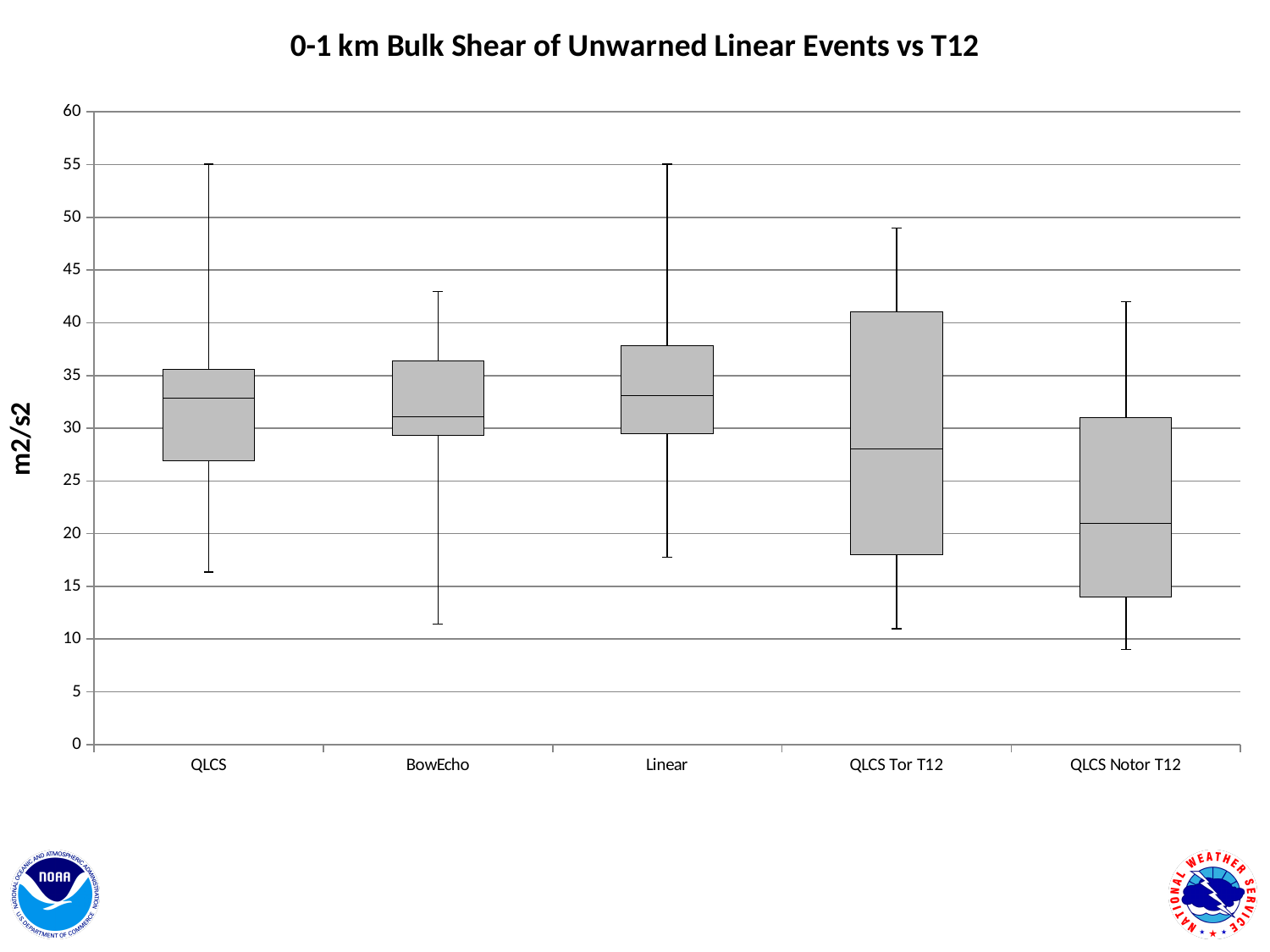
Which has the higher median, QLCS or QLCS Notor T12? QLCS Which category has the lowest bottom whisker? QLCS Notor T12 What is the title of the chart? 0-1 km Bulk Shear of Unwarned Linear Events vs T12 How many categories are shown on the x axis? 5 What is the label on the y axis? m2/s2 Is the median for QLCS Notor T12 greater or less than 25? less Which category has the tallest box (largest interquartile range)? QLCS Tor T12 What kind of chart is shown on the slide? Box-and-whisker plot Which category has the lowest median line? QLCS Notor T12 Is the median for Linear greater or less than 30? greater Is the top whisker for BowEcho greater or less than 45? less